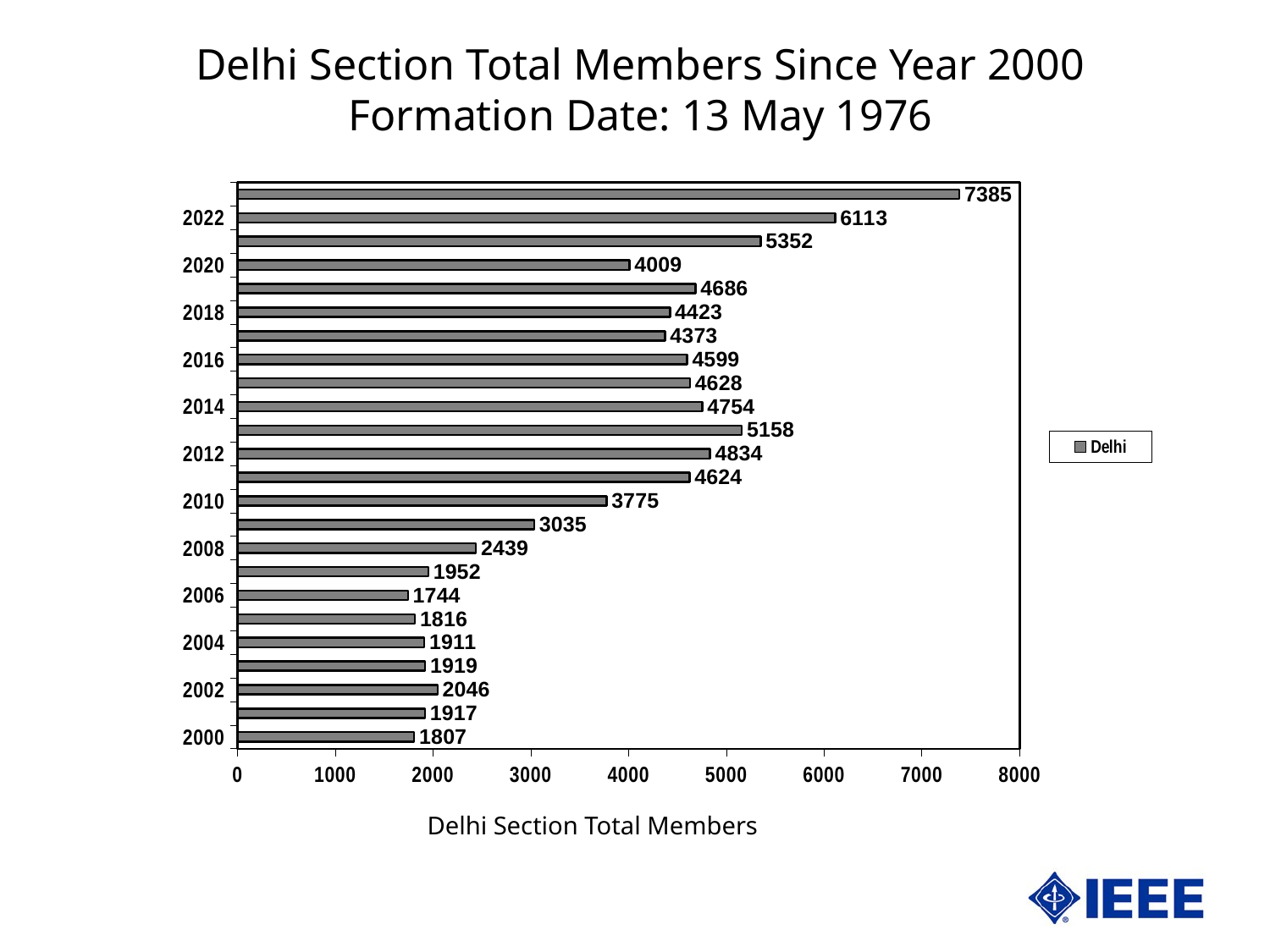
What is the difference between the values for 2022 and 2020? 2104 What is the value for 2020? 4009 How many bars are plotted on the chart? 24 What is the value for 2022? 6113 Which is larger, the value for 2012 or the value for 2014? 2012 What entry does the legend list? Delhi What is the value for 2000? 1807 What is the value for 2010? 3775 Which year has the lowest value among the labelled years? 2006 What type of chart is shown on the slide? bar chart Is the value for 2008 greater or less than 3000? less What is the highest value shown on the chart? 7385